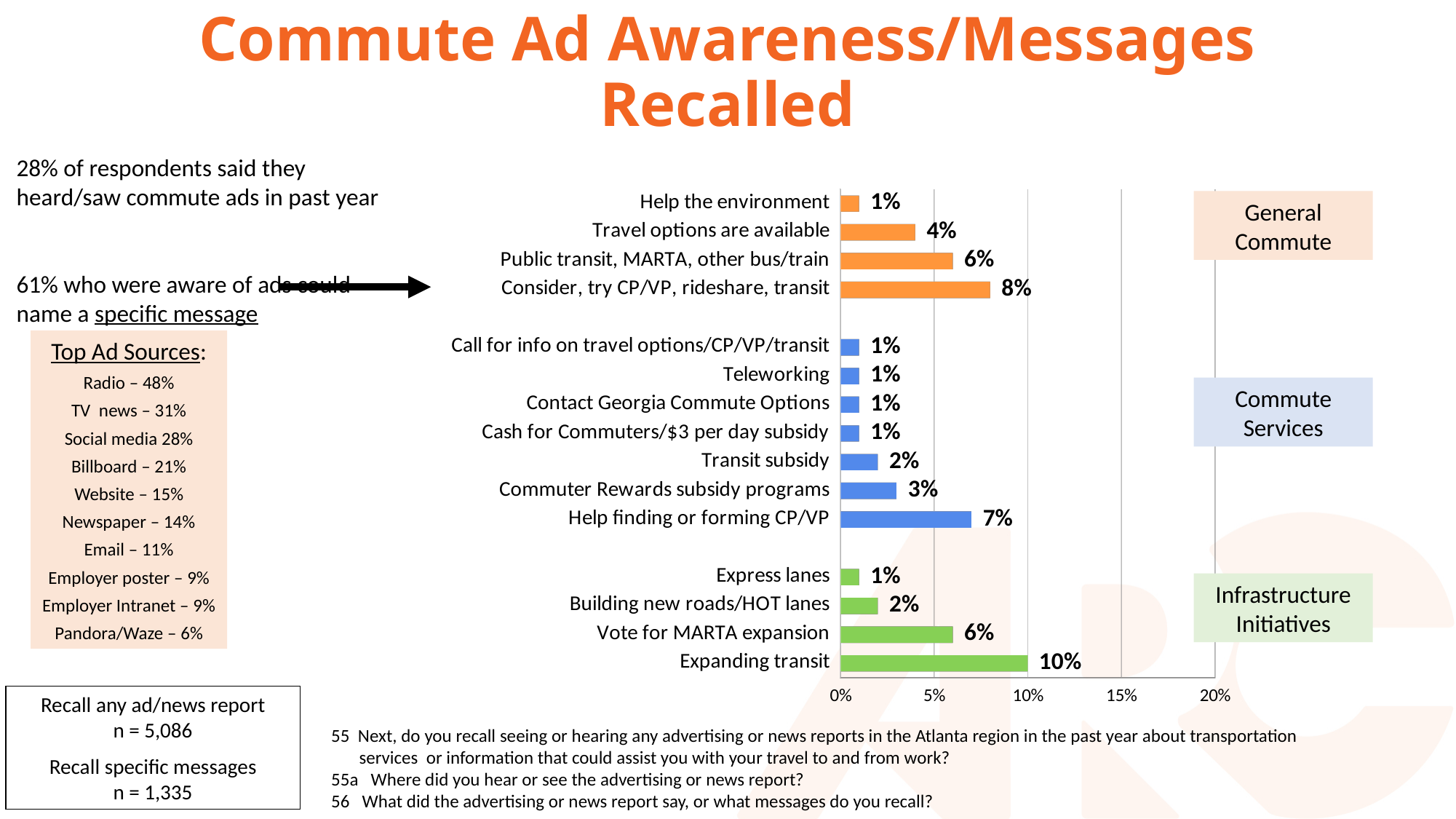
What value is shown for "Commuter Rewards subsidy programs"? 3% Is the value for "Expanding transit" greater or less than 5%? greater How many message categories are plotted in the chart? 15 What percentage of respondents recalled the message "Expanding transit"? 10% Which message has the highest recall value in the chart? Expanding transit What value is shown for "Consider, try CP/VP, rideshare, transit"? 8% What is the difference between the values for "Consider, try CP/VP, rideshare, transit" and "Travel options are available"? 4% Which group label is shown next to the green bars? Infrastructure Initiatives What type of chart is shown on the slide? Bar chart What is the difference between the values for "Expanding transit" and "Vote for MARTA expansion"? 4% Which is larger, the value for "Public transit, MARTA, other bus/train" or the value for "Building new roads/HOT lanes"? Public transit, MARTA, other bus/train What value is shown for "Help finding or forming CP/VP"? 7%